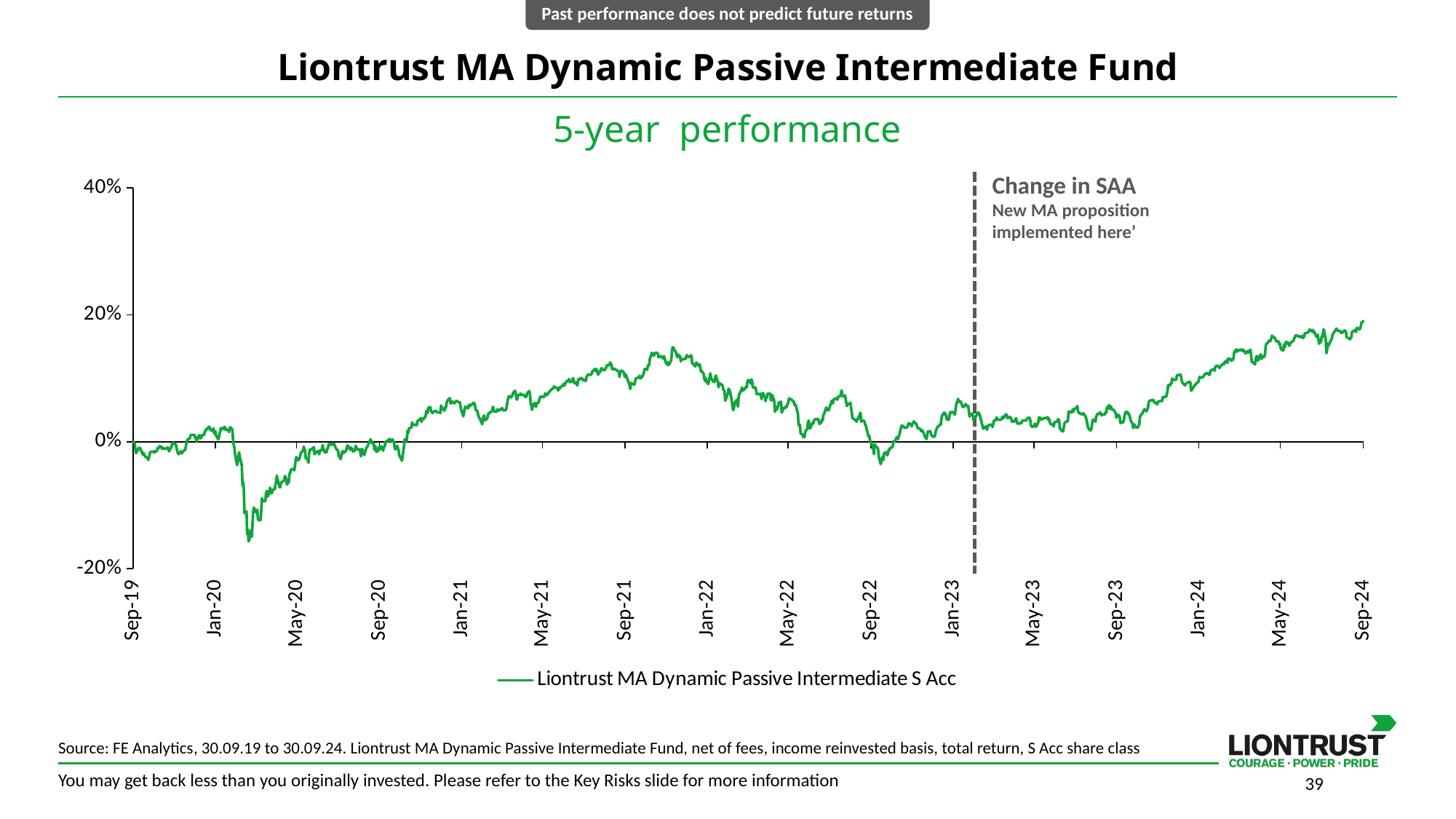
What is the title of the chart? 5-year performance How many series does the legend list? 1 Is the value at Sep-23 greater or less than 20%? less Is the value at Sep-24 greater or less than 0%? greater Is the value at Jan-24 greater or less than 0%? greater Which is larger, the value at Sep-24 or the value at Sep-23? Sep-24 How many date labels are shown on the x axis? 16 Overall, does the line rise or fall from Sep-19 to Sep-24? rise Does the line rise or fall between Sep-23 and Sep-24? rise What kind of chart is shown on the slide? line chart What is the name of the series shown in the legend? Liontrust MA Dynamic Passive Intermediate S Acc